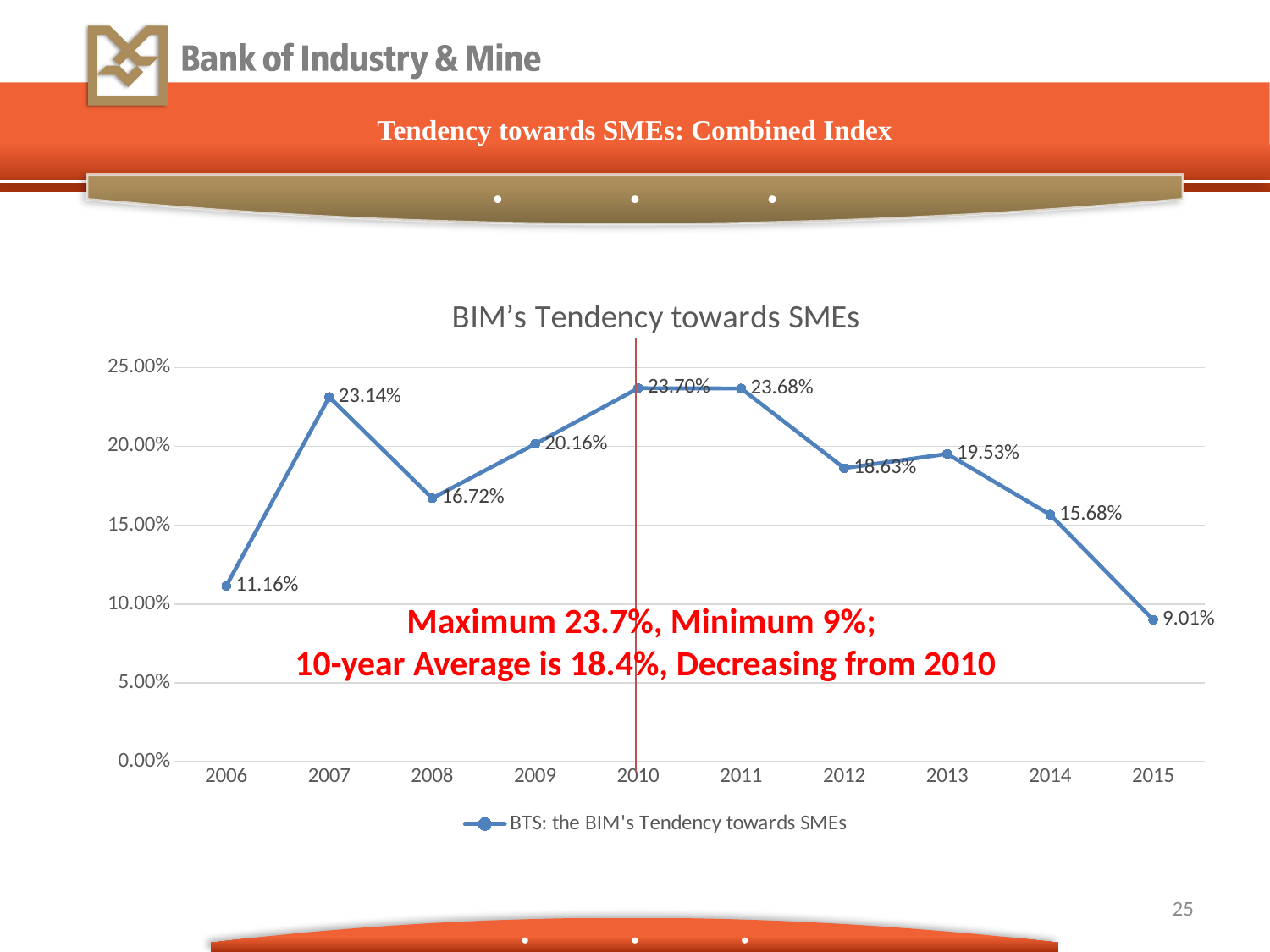
What is the difference between the 2014 and 2015 values in the BIM's Tendency towards SMEs chart? 6.67% Which year has the larger value, 2009 or 2012? 2009 What kind of chart is shown on the slide? line chart What is the difference between the 2007 and 2006 values in the BIM's Tendency towards SMEs chart? 11.98% What is the value for 2015 in the BIM's Tendency towards SMEs chart? 9.01% Do the values rise or fall from 2013 to 2015? fall Which year has the highest value in the BIM's Tendency towards SMEs chart? 2010 How many years are plotted in the BIM's Tendency towards SMEs chart? 10 Which year has the lowest value in the BIM's Tendency towards SMEs chart? 2015 Is the value for 2008 greater or less than 15.00%? greater What is the value for 2013 in the BIM's Tendency towards SMEs chart? 19.53% What is the value for 2006 in the BIM's Tendency towards SMEs chart? 11.16%